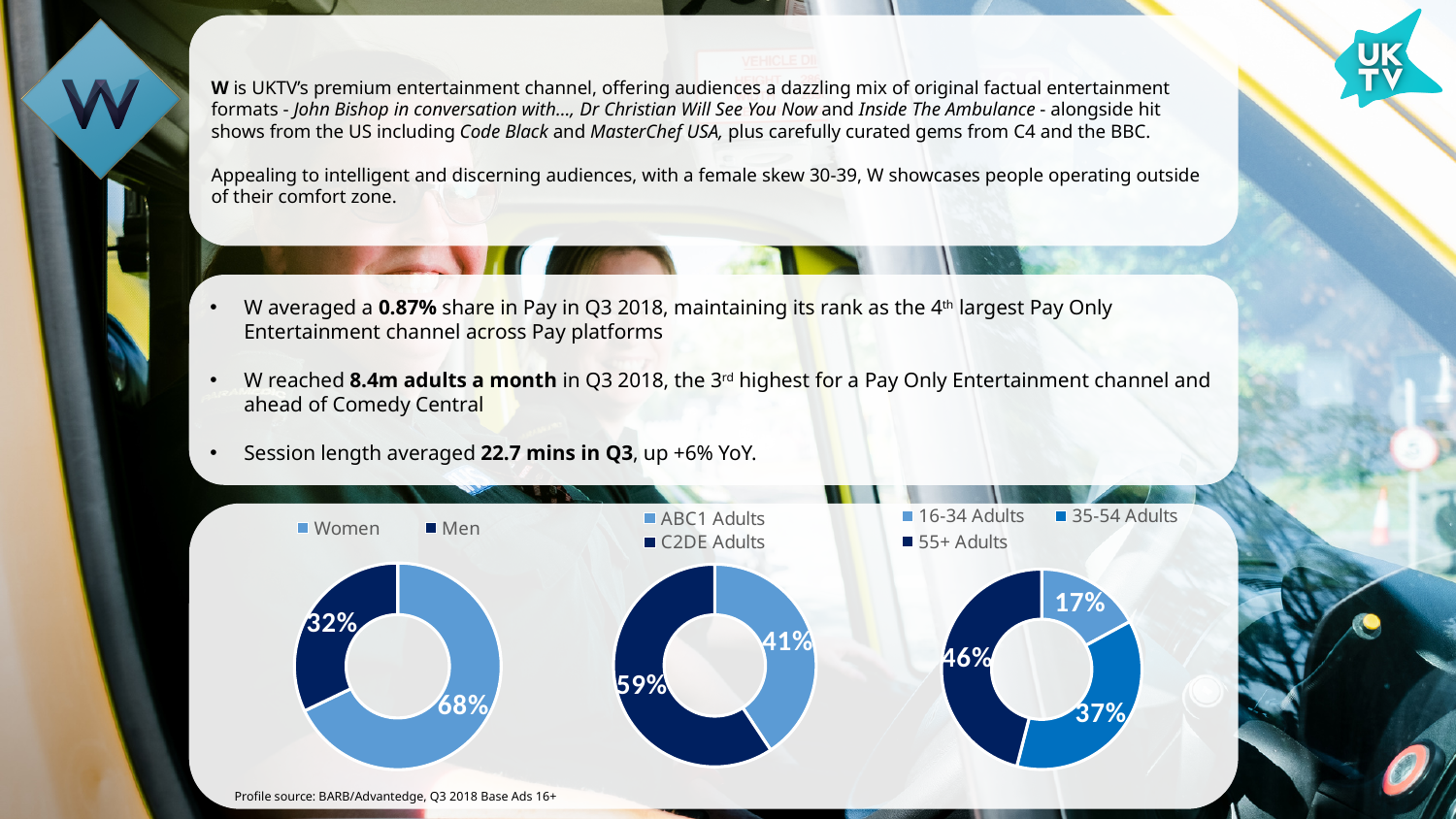
In the right doughnut chart (age groups), what share is 16-34 Adults? 17% In the right doughnut chart (age groups), which age group has the smallest share? 16-34 Adults In the middle doughnut chart (ABC1/C2DE Adults), which segment is larger, ABC1 Adults or C2DE Adults? C2DE Adults What type of chart is used for the three audience profile charts at the bottom of the slide? Doughnut chart In the right doughnut chart (age groups), which age group has the largest share? 55+ Adults In the left doughnut chart (Women/Men), what is the difference between the Women and Men shares? 36 percentage points How many categories does the legend of the right doughnut chart (age groups) list? 3 In the middle doughnut chart (ABC1/C2DE Adults), what share is ABC1 Adults? 41% In the right doughnut chart (age groups), what share is 55+ Adults? 46% In the left doughnut chart (Women/Men), what share is Women? 68% In the left doughnut chart (Women/Men), what share is Men? 32% In the middle doughnut chart (ABC1/C2DE Adults), what share is C2DE Adults? 59%